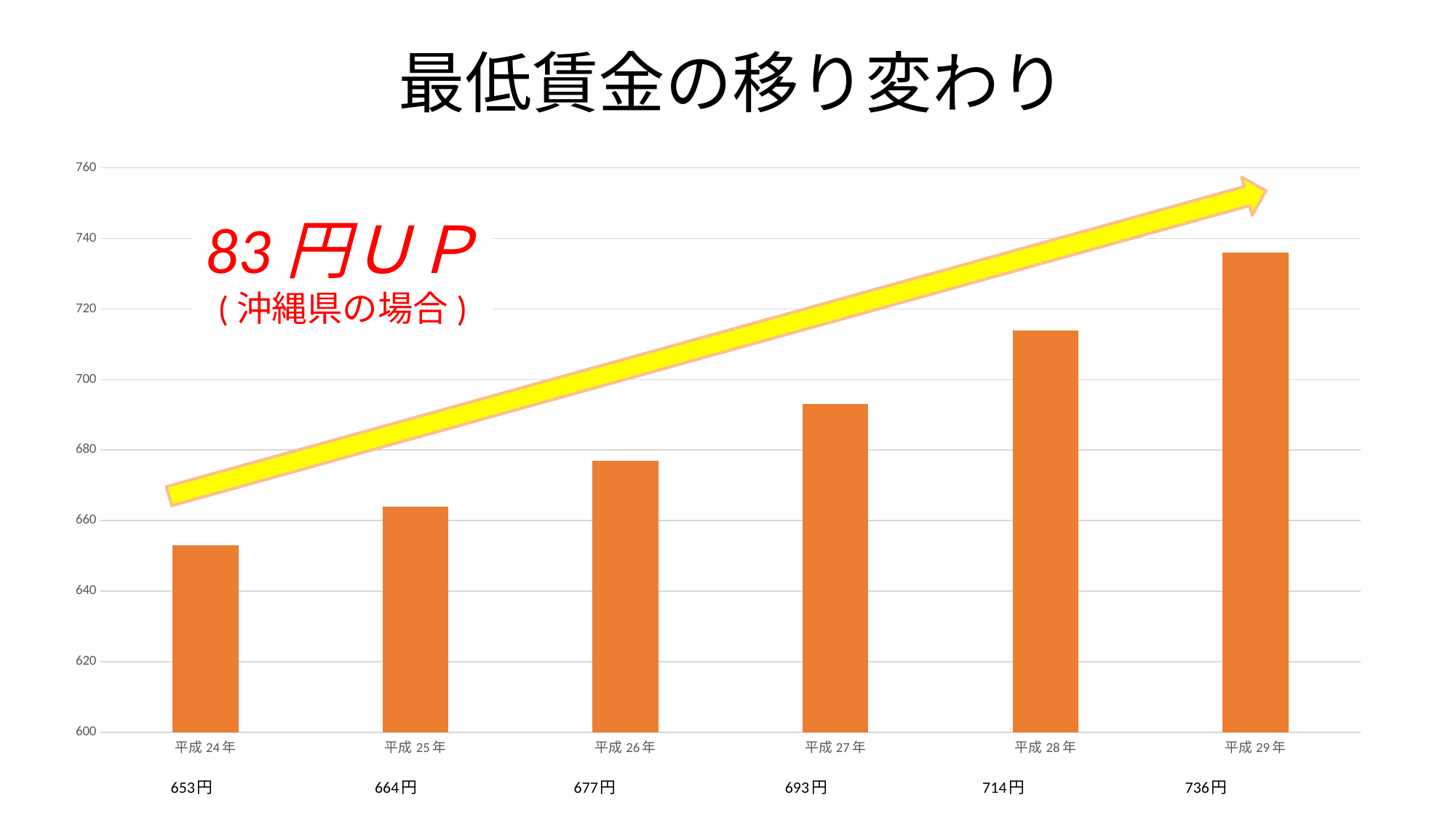
What is the value for 平成29年? 736円 What is the difference between the values for 平成28年 and 平成27年? 21円 Do the values rise or fall from 平成24年 to 平成29年? rise Is the value for 平成28年 greater or less than 700? greater What is the difference between the values for 平成29年 and 平成24年? 83円 What is the value for 平成24年? 653円 Which year has the lowest value? 平成24年 What is the value for 平成27年? 693円 Which year has the highest value? 平成29年 How many years are shown on the x axis? 6 What kind of chart is shown on the slide? bar chart Which is larger, the value for 平成25年 or the value for 平成26年? 平成26年